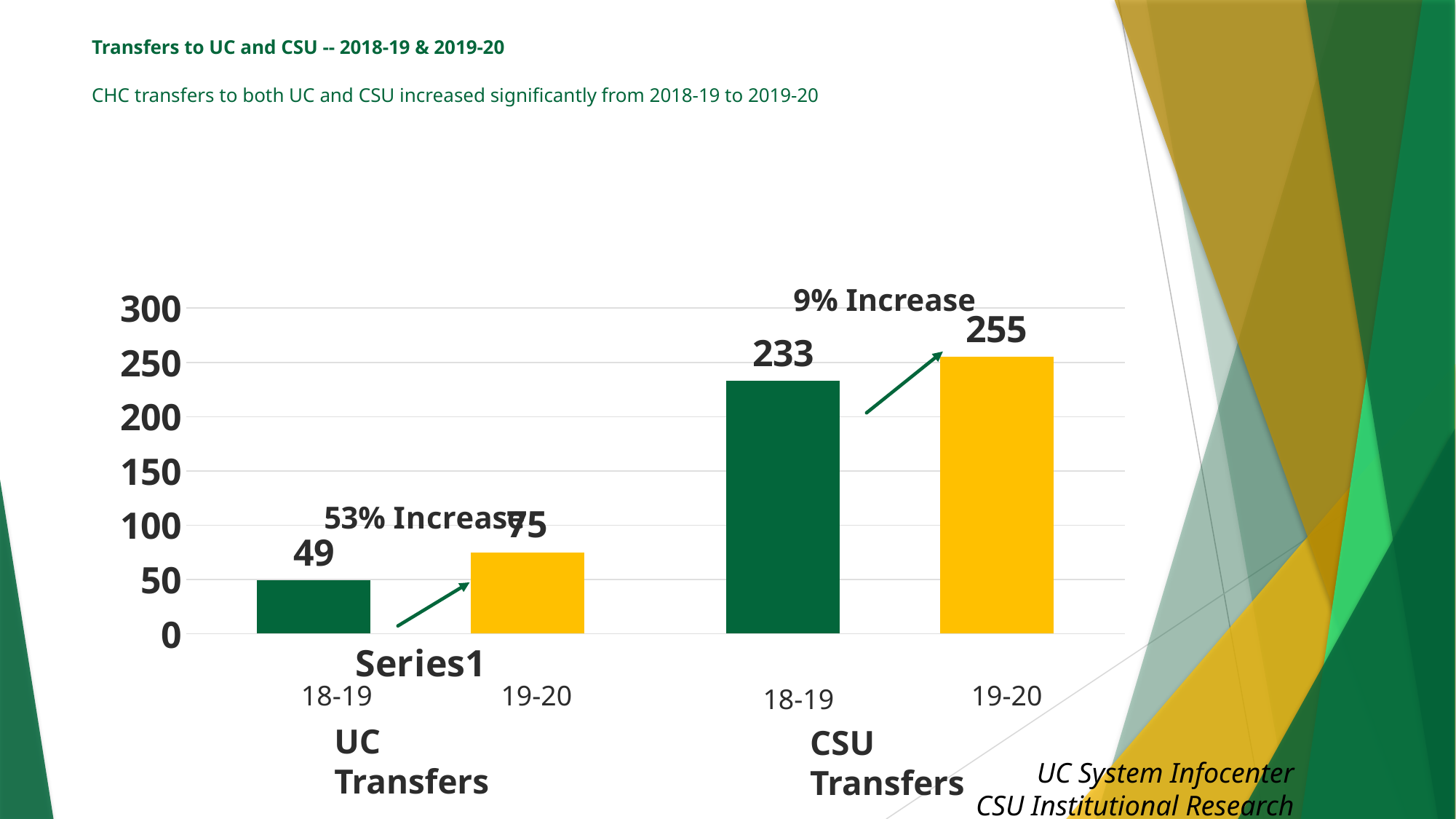
Which bar has the lowest value? UC Transfers 18-19 Which is larger, UC Transfers in 19-20 or CSU Transfers in 18-19? CSU Transfers in 18-19 What percentage increase is labelled for CSU Transfers from 18-19 to 19-20? 9% Increase What is the difference between UC Transfers in 19-20 and 18-19? 26 What is the value for UC Transfers in 19-20? 75 What is the value for CSU Transfers in 19-20? 255 Which bar has the highest value? CSU Transfers 19-20 What is the value for CSU Transfers in 18-19? 233 What is the value for UC Transfers in 18-19? 49 What is the difference between CSU Transfers in 19-20 and 18-19? 22 What percentage increase is labelled for UC Transfers from 18-19 to 19-20? 53% Increase What kind of chart is shown on the slide? Bar chart